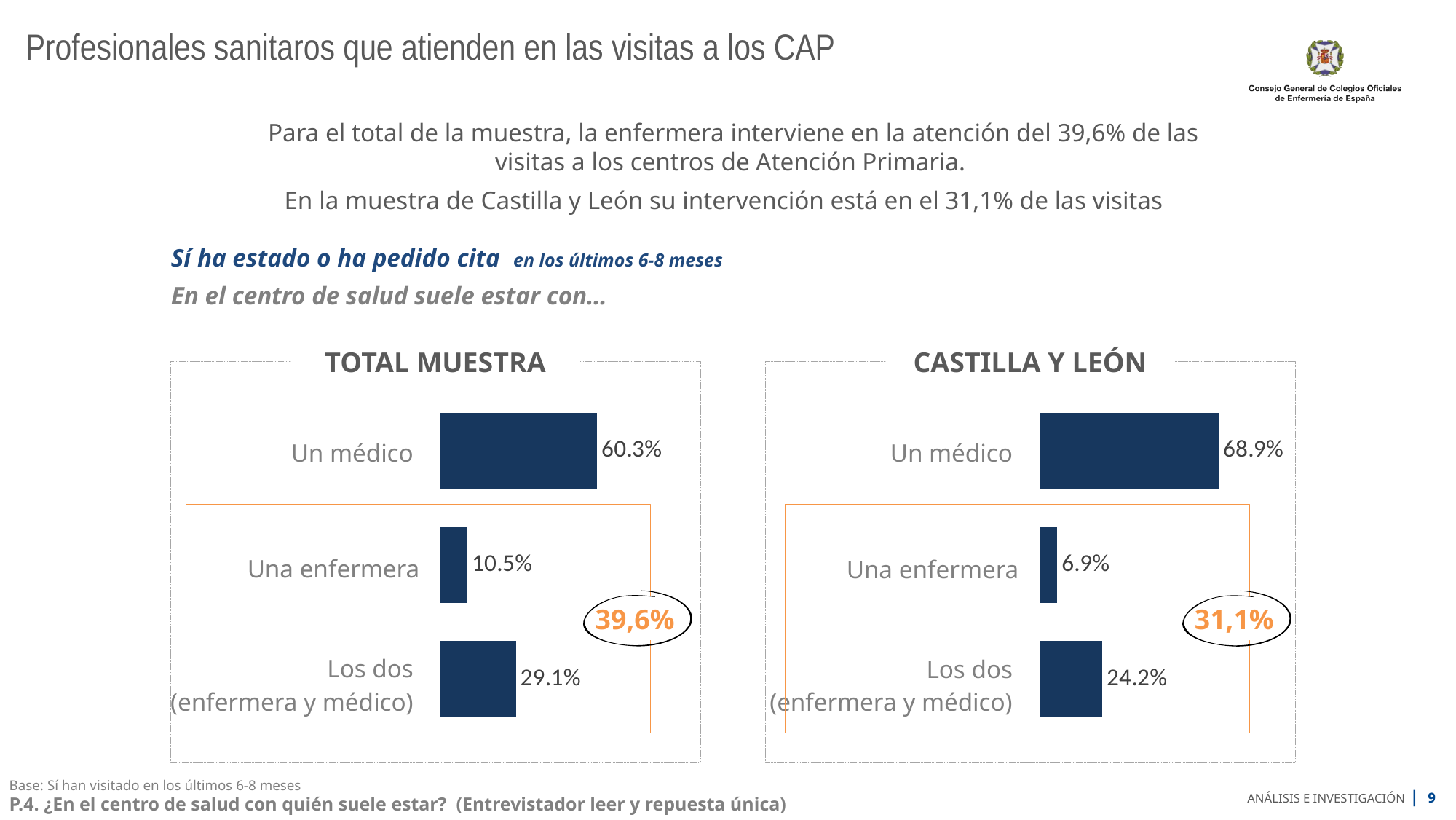
In the CASTILLA Y LEÓN chart, what is the value for Una enfermera? 6.9% What percentage is circled in orange next to the CASTILLA Y LEÓN chart? 31,1% Which is larger: Una enfermera in the TOTAL MUESTRA chart or Una enfermera in the CASTILLA Y LEÓN chart? TOTAL MUESTRA How many categories does the TOTAL MUESTRA chart show? 3 In the TOTAL MUESTRA chart, what is the value for Una enfermera? 10.5% In the TOTAL MUESTRA chart, what is the difference between Un médico and Los dos (enfermera y médico)? 31.2% In the CASTILLA Y LEÓN chart, which category has the highest value? Un médico In the CASTILLA Y LEÓN chart, what is the value for Los dos (enfermera y médico)? 24.2% In the TOTAL MUESTRA chart, which category has the lowest value? Una enfermera In the TOTAL MUESTRA chart, what is the value for Un médico? 60.3% What type of chart is the CASTILLA Y LEÓN chart? Bar chart In the CASTILLA Y LEÓN chart, what is the difference between Un médico and Una enfermera? 62.0%